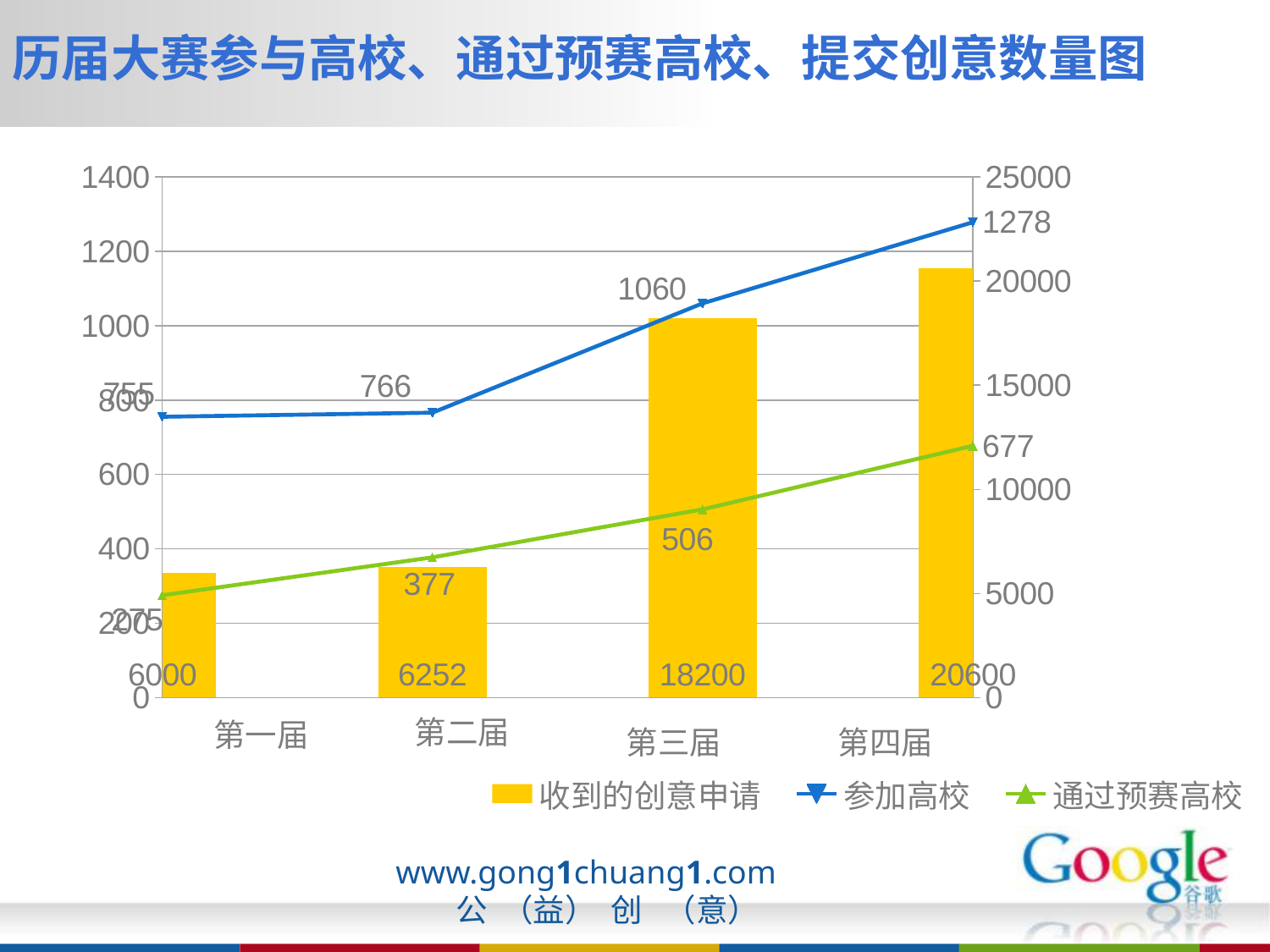
What is the difference between the 收到的创意申请 values for 第四届 and 第三届? 2400 Which category has the lowest value for 通过预赛高校? 第一届 How many categories are shown on the x axis? 4 Do the 参加高校 values rise or fall from 第一届 to 第四届? rise What is the value of 通过预赛高校 for 第二届? 377 What is the difference between the 参加高校 values for 第三届 and 第二届? 294 How many series does the legend list? 3 What is the value of 参加高校 for 第四届? 1278 What is the value of 收到的创意申请 for 第一届? 6000 What is the value of 收到的创意申请 for 第三届? 18200 Which category has the highest value for 收到的创意申请? 第四届 Which is larger, the 通过预赛高校 value for 第三届 or for 第四届? 第四届